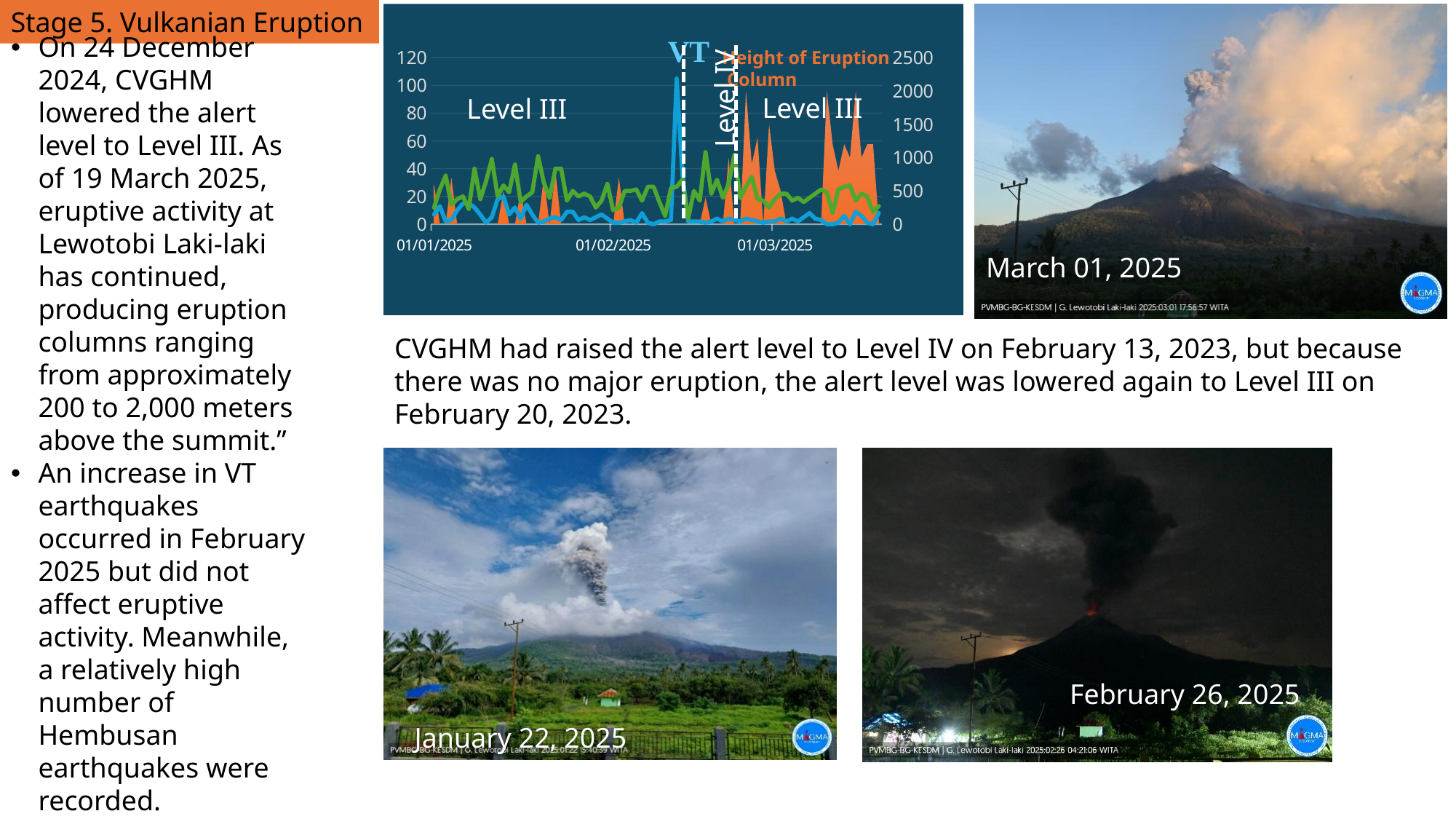
What is the highest value shown on the left vertical axis of the chart? 120 What kind of chart is shown on the slide? combination area and line chart How many date labels are shown along the x axis of the chart? 3 Is the VT series (blue line) value at 01/01/2025 greater or less than 40 on the left axis? less What is the last date label on the x axis of the chart? 01/03/2025 Which series in the chart is labelled 'VT'? the blue line Which alert level is labelled on the chart between the two dashed vertical lines? Level IV Which alert level is labelled on the chart before the first dashed vertical line? Level III What is the highest value shown on the right vertical axis of the chart? 2500 Is the peak value of the VT series (blue line) greater or less than 80 on the left axis? greater Is the highest peak of the Height of Eruption Column series greater or less than 1500 on the right axis? greater What is the first date label on the x axis of the chart? 01/01/2025